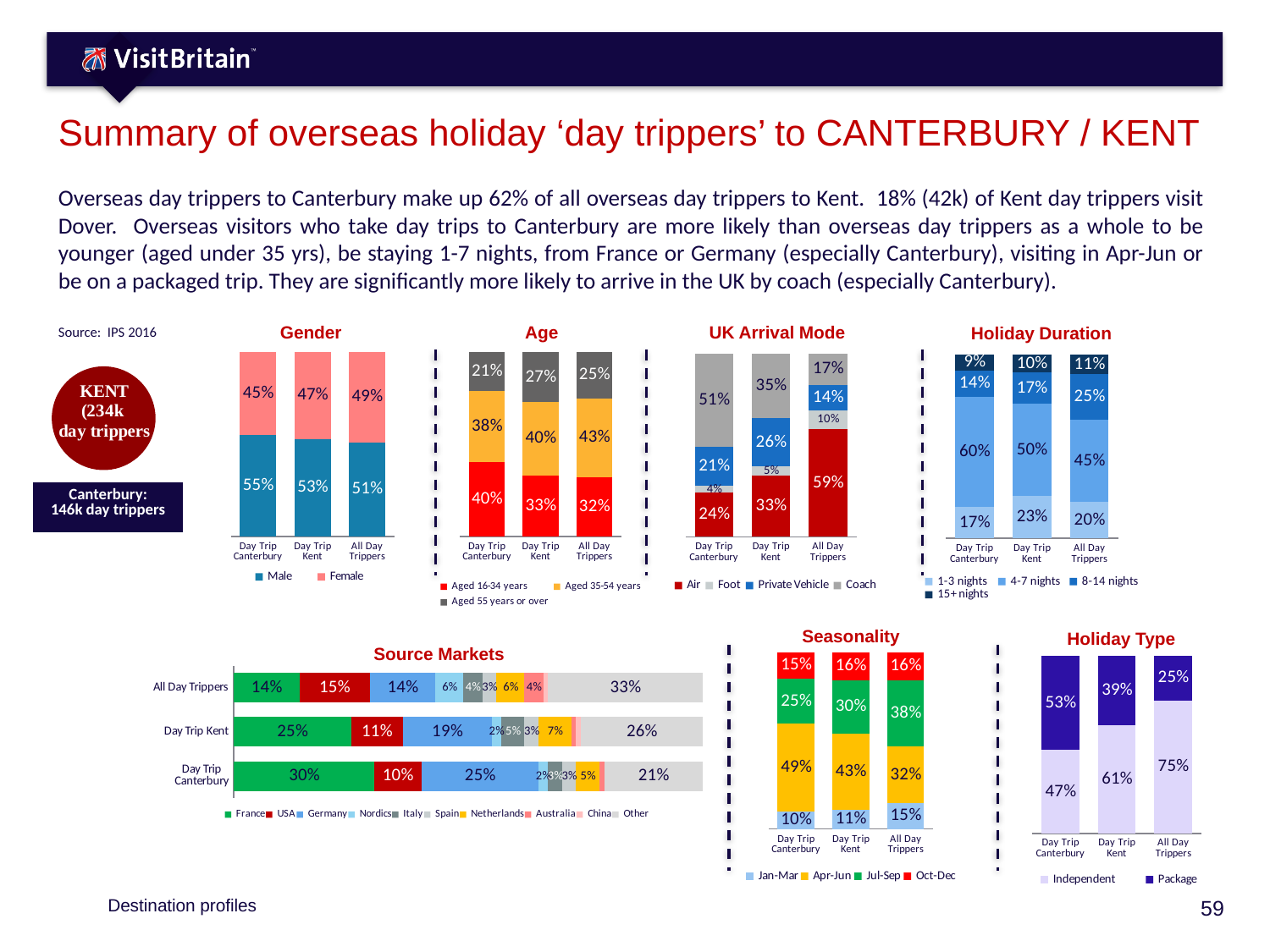
In the Age chart, what share of Day Trip Kent visitors are Aged 35-54 years? 40% In the Holiday Type chart, what is the Package share for All Day Trippers? 25% In the Source Markets chart, which is larger for Day Trip Kent: the Germany share or the USA share? Germany In the Gender chart, what percentage of Day Trip Canterbury visitors are Male? 55% In the UK Arrival Mode chart, which category has the highest Coach share? Day Trip Canterbury In the Holiday Duration chart, how many series does the legend list? 4 In the Seasonality chart, which category has the lowest Apr-Jun share? All Day Trippers In the UK Arrival Mode chart, what is the difference between the Air share for All Day Trippers and for Day Trip Canterbury? 35% In the Seasonality chart, what is the Jul-Sep share for Day Trip Kent? 30% In the Holiday Duration chart, what percentage of Day Trip Canterbury visitors stay 4-7 nights? 60% In the Source Markets chart, what is the France share for Day Trip Canterbury? 30% What type of chart is the Holiday Type chart? Stacked bar chart